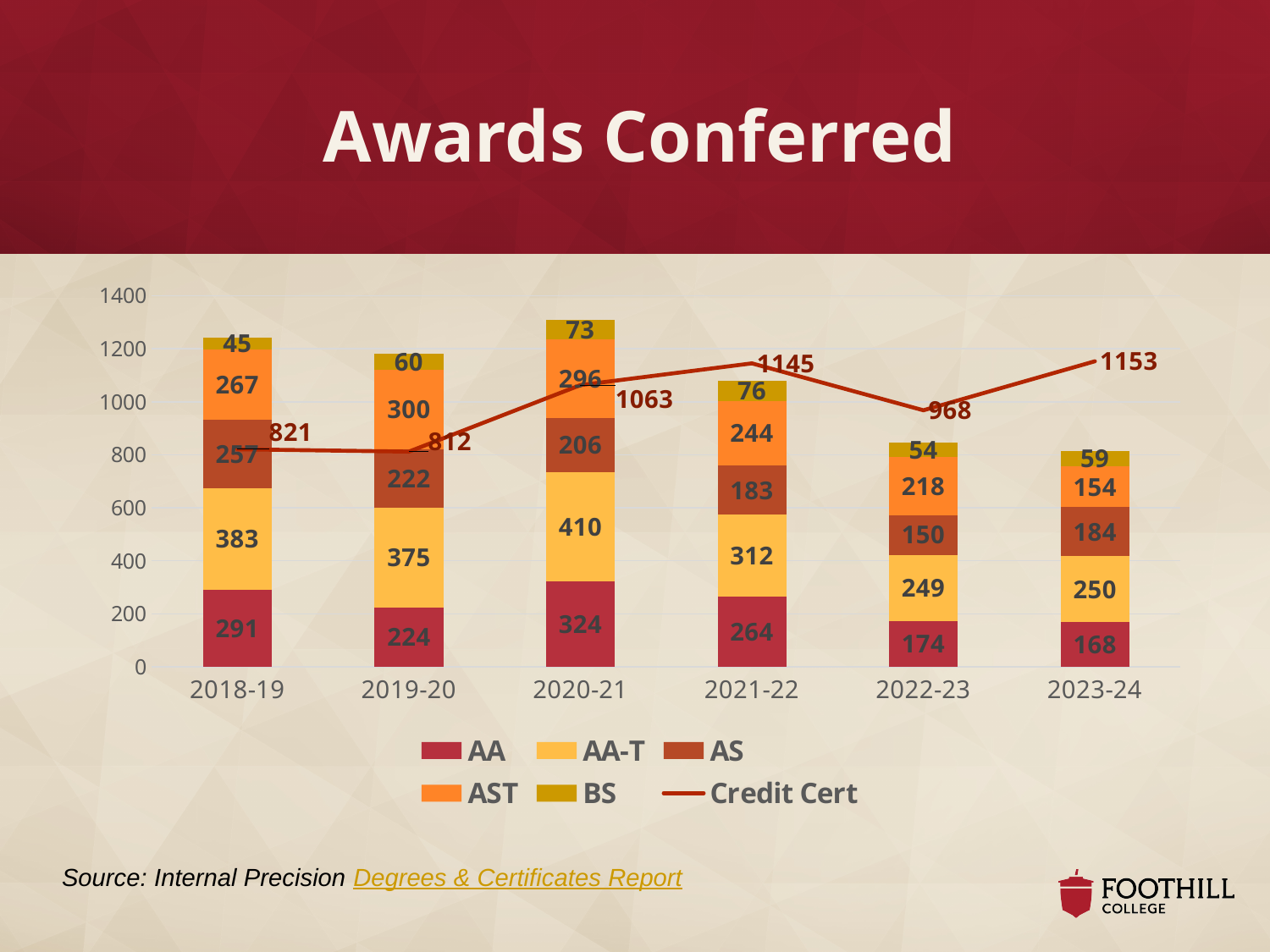
What is the AA-T value for 2020-21? 410 What is the BS value for 2018-19? 45 How many series does the legend list? 6 Which is larger, the AS value for 2018-19 or the AS value for 2021-22? 2018-19 What is the difference between the AST values for 2019-20 and 2023-24? 146 What kind of chart is shown on the slide? Stacked bar chart with a line How many years are shown on the x axis? 6 What is the Credit Cert value for 2022-23? 968 Does the AA value rise or fall from 2020-21 to 2023-24? Fall Which year has the highest Credit Cert value? 2023-24 What is the total of the stacked bar for 2022-23? 845 Which year has the lowest AA value? 2023-24